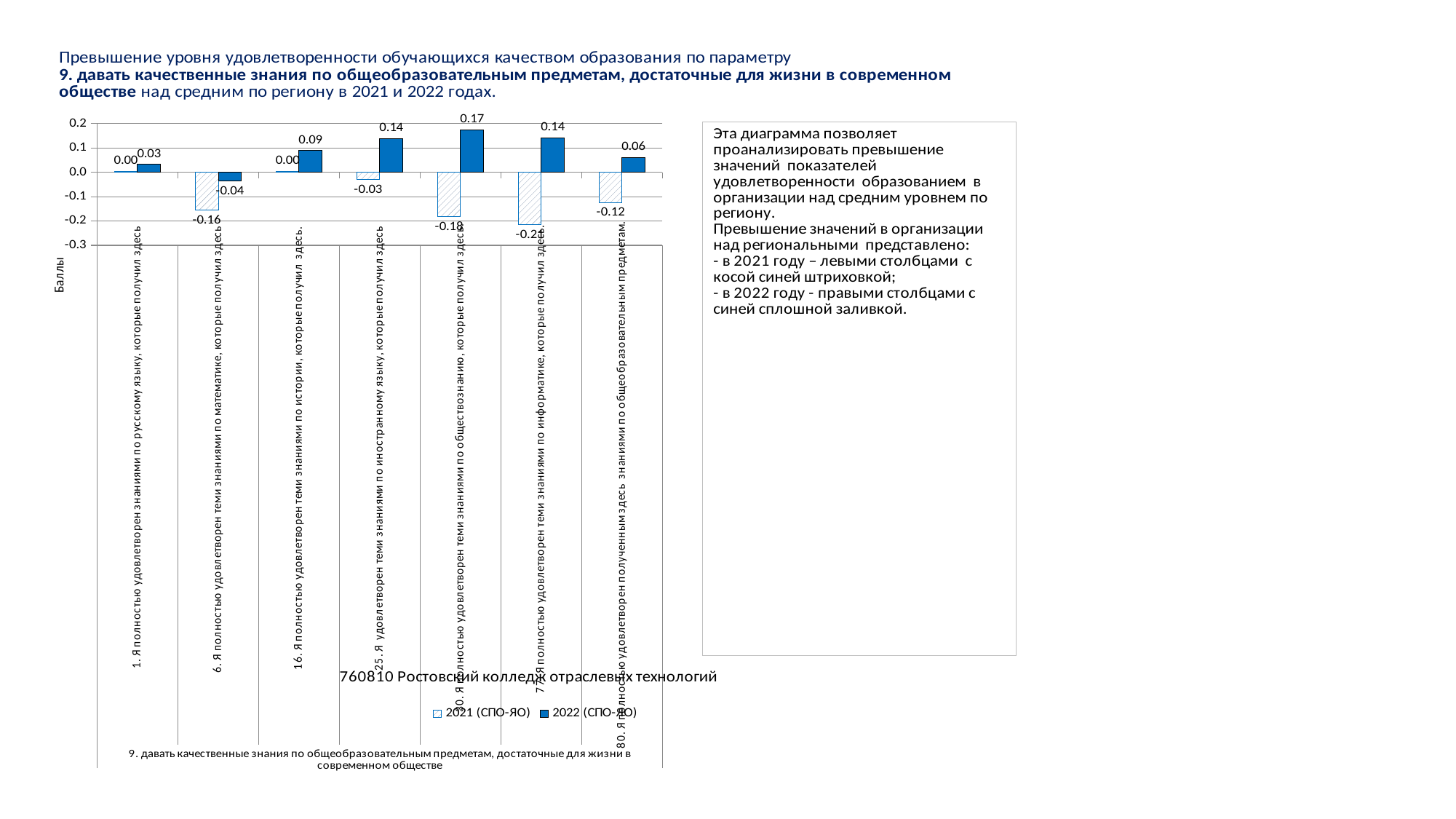
What is the 2022 (СПО-ЯО) value for the category '6. Я полностью удовлетворен теми знаниями по математике, которые получил здесь'? -0.04 How many series does the chart legend list? 2 What is the 2021 (СПО-ЯО) value for the category '80. Я полностью удовлетворен полученным здесь знаниями по общеобразовательным предметам'? -0.12 By how much does the 2022 (СПО-ЯО) value exceed the 2021 (СПО-ЯО) value for the category '25. Я удовлетворен теми знаниями по иностранному языку, которые получил здесь'? 0.17 How many categories are shown on the x axis of the chart? 7 Which category has the lowest 2022 (СПО-ЯО) value? 6. Я полностью удовлетворен теми знаниями по математике, которые получил здесь Which category has the highest 2022 (СПО-ЯО) value? 30. Я полностью удовлетворен теми знаниями по обществознанию, которые получил здесь What type of chart is shown on the slide? Bar chart What is the 2021 (СПО-ЯО) value for the category '6. Я полностью удовлетворен теми знаниями по математике, которые получил здесь'? -0.16 What is the difference between the 2022 (СПО-ЯО) values for '77. Я полностью удовлетворен теми знаниями по информатике, которые получил здесь' and '80. Я полностью удовлетворен полученным здесь знаниями по общеобразовательным предметам'? 0.08 Which is larger: the 2022 (СПО-ЯО) value for '16. Я полностью удовлетворен теми знаниями по истории, которые получил здесь' or for '25. Я удовлетворен теми знаниями по иностранному языку, которые получил здесь'? 25. Я удовлетворен теми знаниями по иностранному языку, которые получил здесь